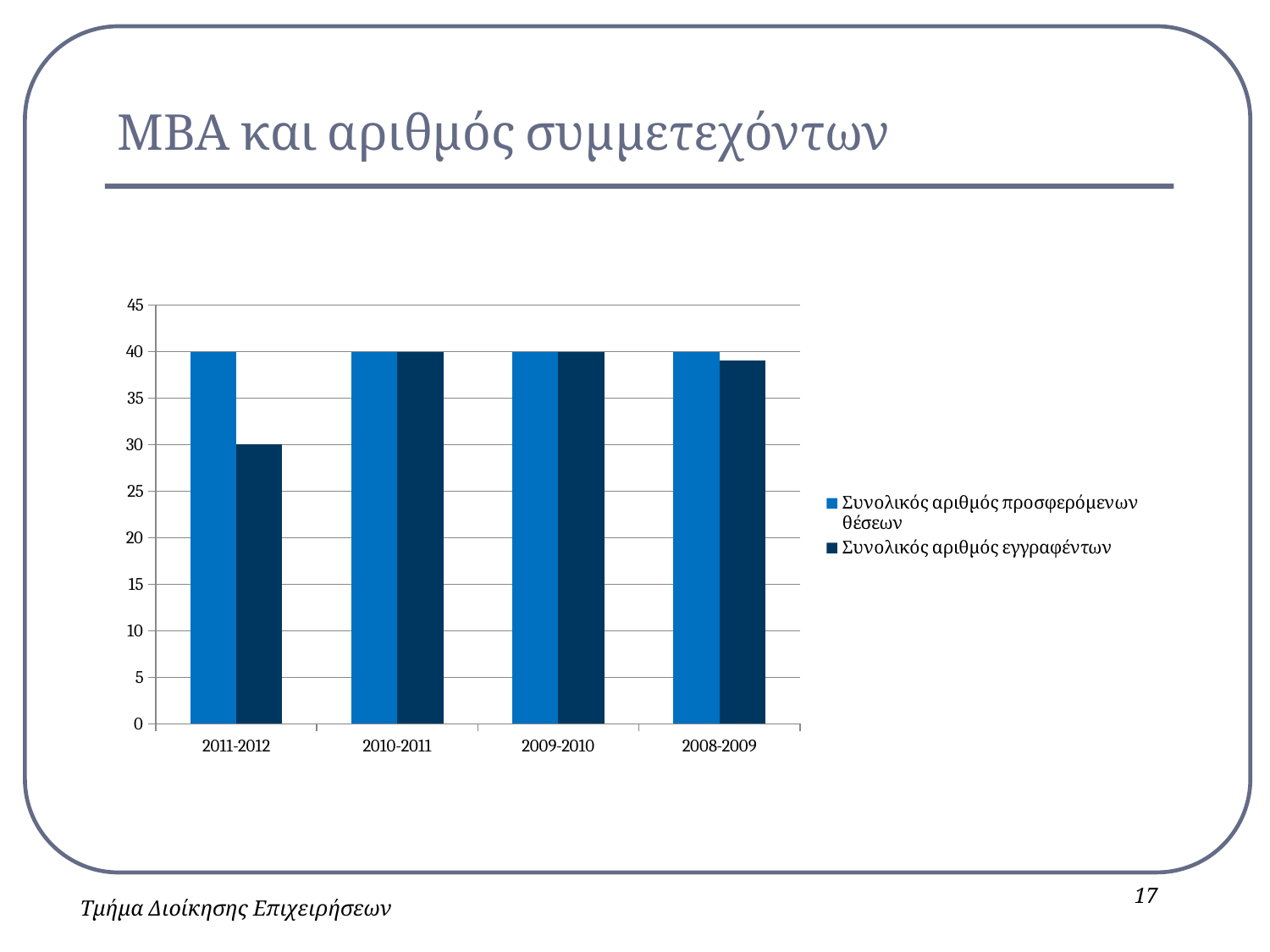
What is the title of the slide containing the chart? MBA και αριθμός συμμετεχόντων Which series is shown in the darker blue colour in the chart? Συνολικός αριθμός εγγραφέντων How many series does the chart's legend list? 2 For 2011-2012, which is larger: Συνολικός αριθμός προσφερόμενων θέσεων or Συνολικός αριθμός εγγραφέντων? Συνολικός αριθμός προσφερόμενων θέσεων What type of chart is shown on the slide? Bar chart What is the difference between Συνολικός αριθμός προσφερόμενων θέσεων and Συνολικός αριθμός εγγραφέντων for 2011-2012? 10 What is the value of Συνολικός αριθμός προσφερόμενων θέσεων for 2011-2012? 40 How many academic years are shown on the x axis of the chart? 4 Is the value of Συνολικός αριθμός εγγραφέντων for 2008-2009 greater or less than 35? greater Which academic year has the lowest value for Συνολικός αριθμός εγγραφέντων? 2011-2012 What is the value of Συνολικός αριθμός εγγραφέντων for 2010-2011? 40 What is the value of Συνολικός αριθμός εγγραφέντων for 2011-2012? 30